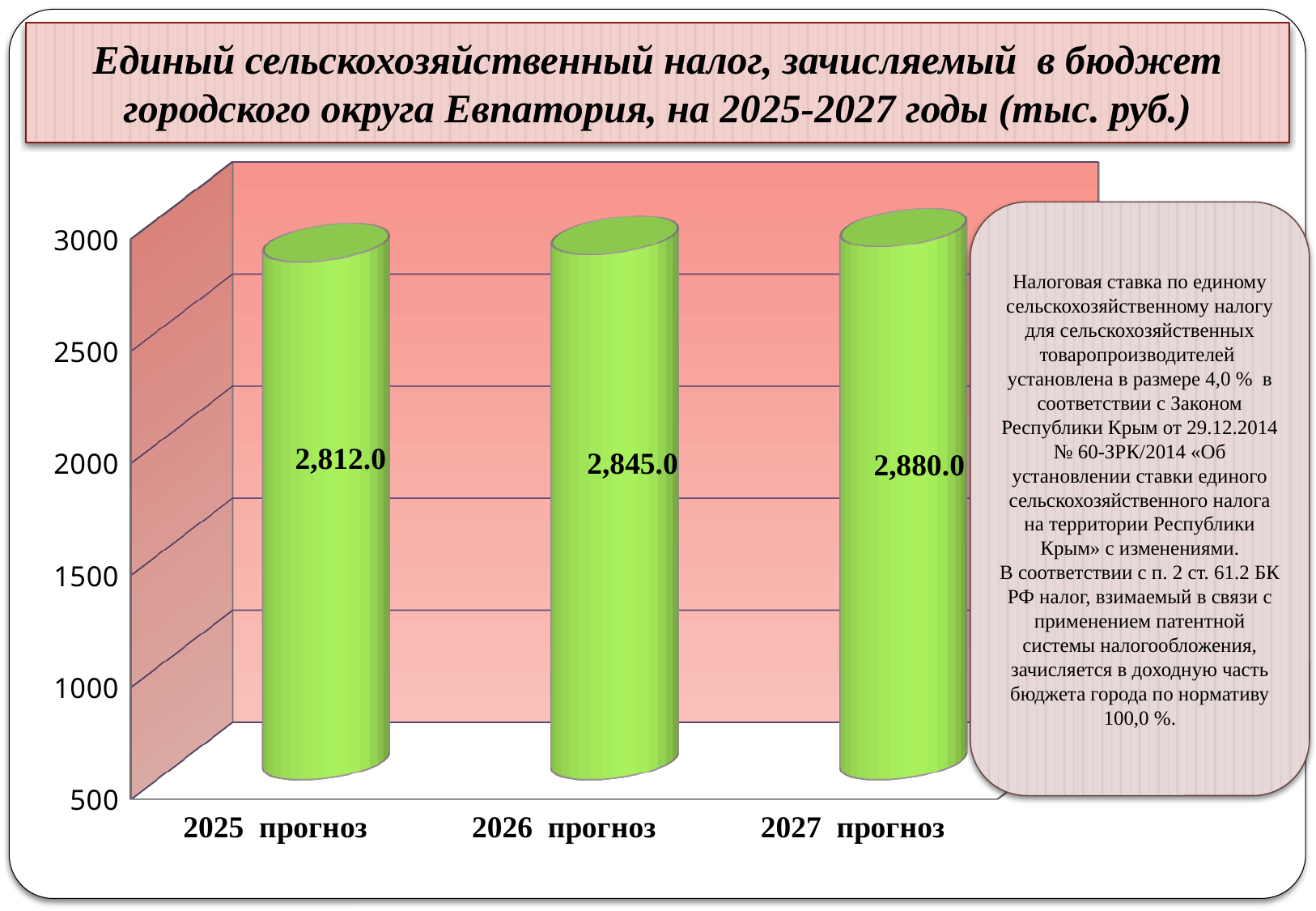
Do the values rise or fall from 2025 to 2027? rise Which year has the highest value? 2027 прогноз Is the value for 2025 прогноз greater or less than 2500? greater What is the difference between the values for 2026 прогноз and 2025 прогноз? 33.0 Which year has the lowest value? 2025 прогноз How many categories are shown on the x axis? 3 What is the value for 2027 прогноз? 2,880.0 What is the value for 2025 прогноз? 2,812.0 Which is larger, the value for 2026 прогноз or 2027 прогноз? 2027 прогноз What is the value for 2026 прогноз? 2,845.0 What is the difference between the values for 2027 прогноз and 2025 прогноз? 68.0 What kind of chart is shown on the slide? bar chart